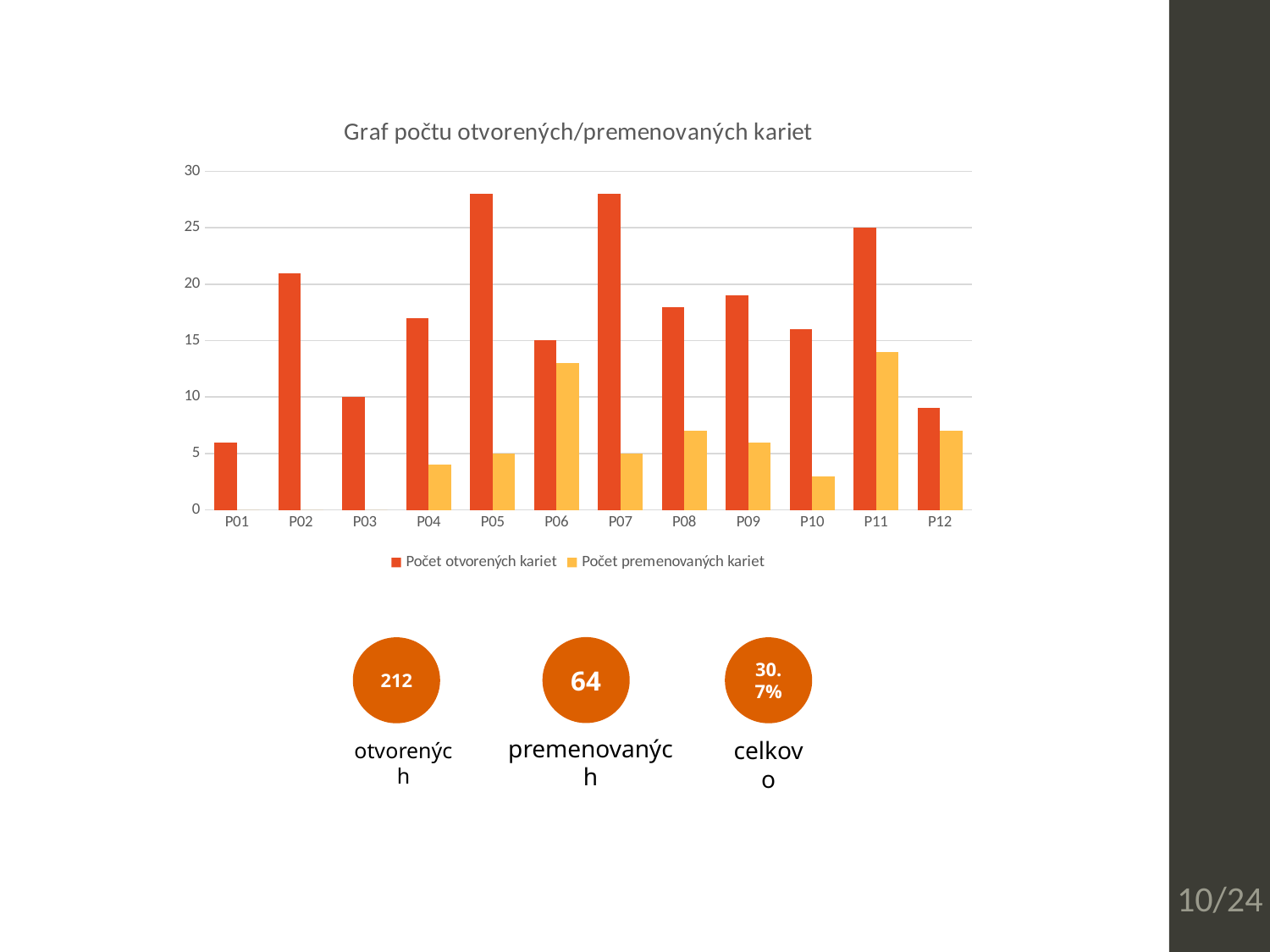
What is the value of Počet otvorených kariet for P03? 10 How many categories are shown on the x axis of the chart? 12 What is the value of Počet otvorených kariet for P11? 25 Which is larger: Počet otvorených kariet for P05 or for P03? P05 Is the value of Počet premenovaných kariet for P06 greater or less than 10? greater What type of chart is shown on the slide? bar chart Which category has the lowest value of Počet otvorených kariet? P01 What is the value of Počet premenovaných kariet for P05? 5 How many series does the chart legend list? 2 Is the value of Počet otvorených kariet for P05 greater or less than 25? greater Is the value of Počet premenovaných kariet for P10 greater or less than 5? less What is the title of the chart? Graf počtu otvorených/premenovaných kariet